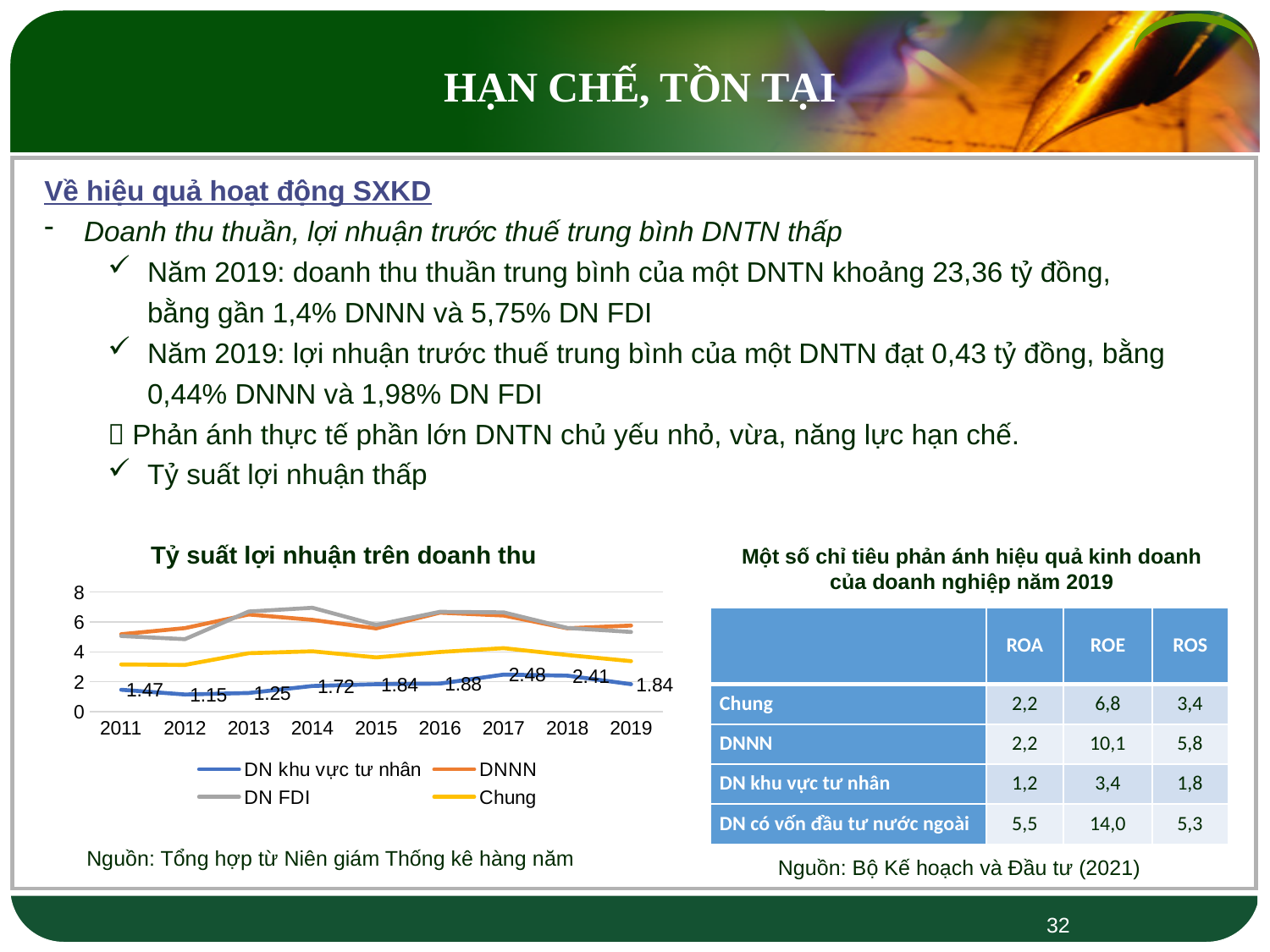
Is the value for Chung in 2011 greater or less than 4? less What is the value for DN khu vực tư nhân in 2017? 2.48 How many series does the chart legend list? 4 In which year is the value for DN khu vực tư nhân lowest? 2012 What is the value for DN khu vực tư nhân in 2019? 1.84 What kind of chart is 'Tỷ suất lợi nhuận trên doanh thu'? line chart What is the difference between the DN khu vực tư nhân values in 2017 and 2012? 1.33 For DN khu vực tư nhân, which year has the larger value, 2014 or 2015? 2015 What is the value for DN khu vực tư nhân in 2011 in the chart 'Tỷ suất lợi nhuận trên doanh thu'? 1.47 In which year is the value for DN khu vực tư nhân highest? 2017 How many years are shown on the x axis of the chart? 9 Is the value for DN FDI in 2014 greater or less than 6? greater